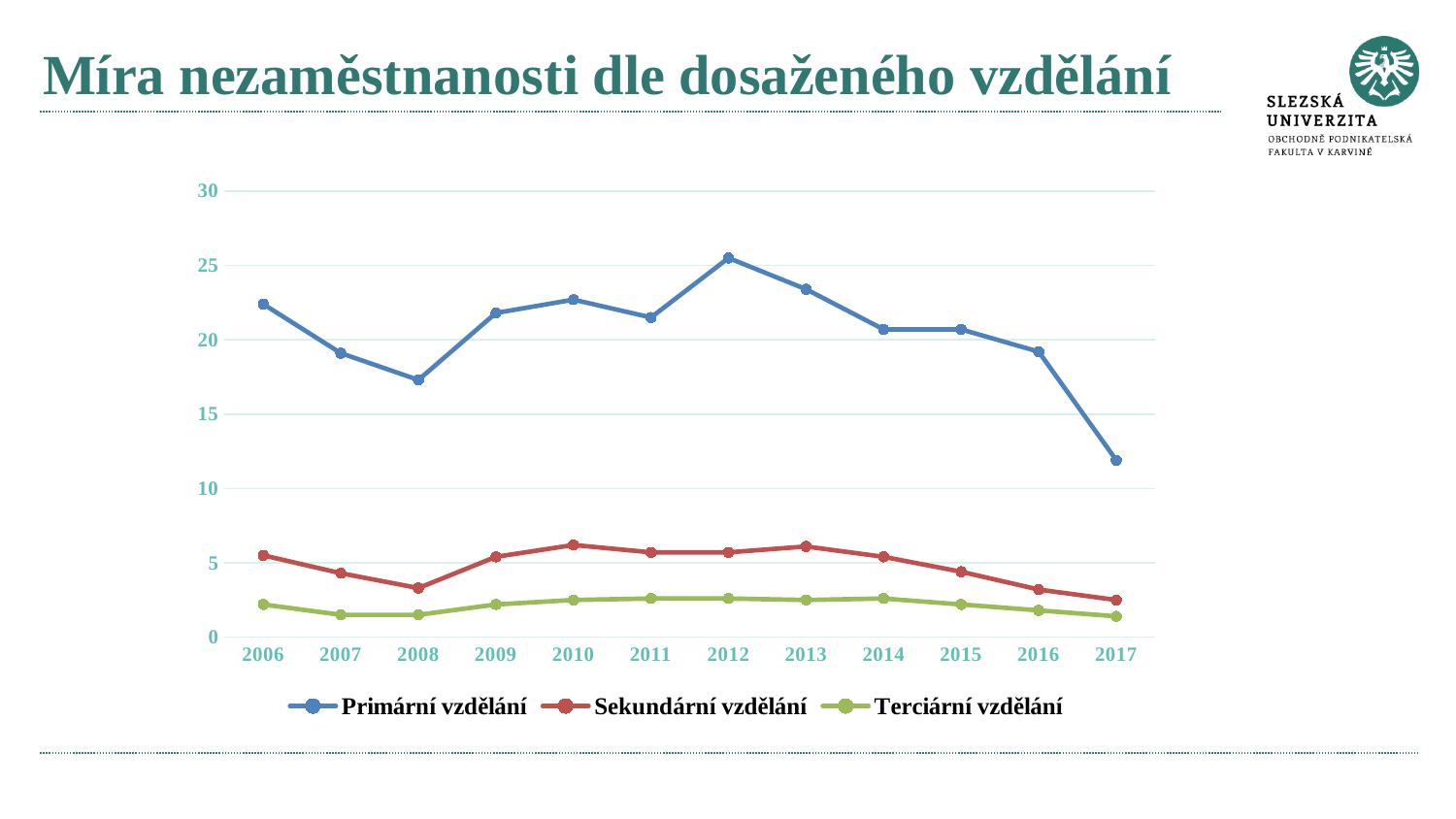
Does the value for Primární vzdělání rise or fall from 2014 to 2017? Fall In which year is the value for Sekundární vzdělání lowest? 2017 Which is larger for Primární vzdělání: the value in 2006 or the value in 2007? 2006 How many series does the legend list? 3 Is the value for Sekundární vzdělání in 2010 greater or less than 5? greater How many years are shown on the x axis? 12 What is the title of the slide? Míra nezaměstnanosti dle dosaženého vzdělání Is the value for Primární vzdělání in 2017 greater or less than 15? less In which year is the value for Primární vzdělání highest? 2012 In which year is the value for Primární vzdělání lowest? 2017 Is the value for Primární vzdělání in 2006 greater or less than 20? greater What kind of chart is shown on the slide? Line chart